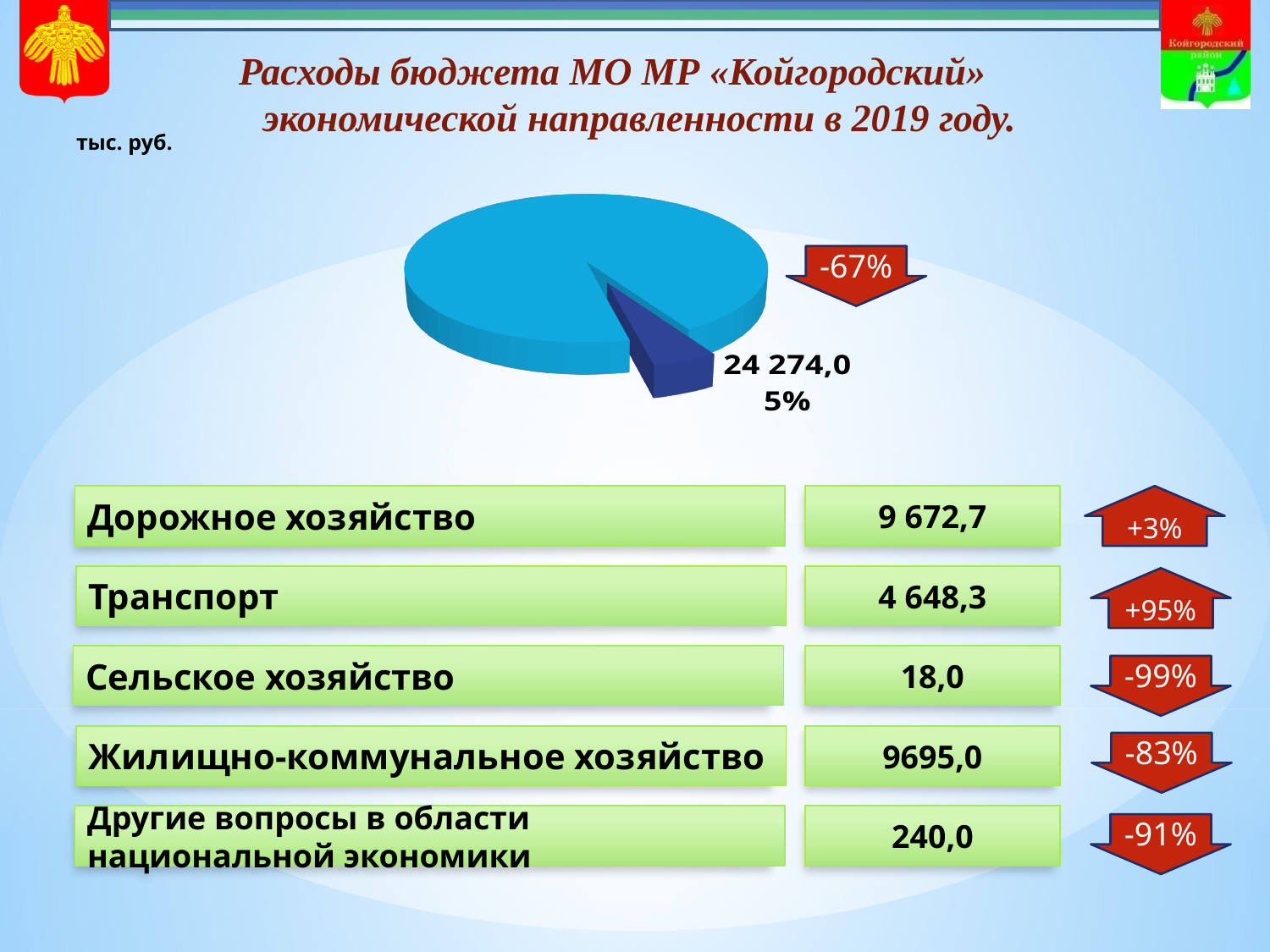
What share of the pie does the small dark blue slice represent? 5% How many slices does the pie chart have? 2 Is the share of the light blue slice in the pie chart greater or less than 50%? greater What kind of chart is shown on the slide? pie chart What value is printed on the small dark blue slice of the pie chart? 24 274,0 What percentage change is shown in the red arrow next to the pie chart? -67% In what units are the values on the slide given, according to the label in the top left? тыс. руб. Which slice of the pie chart is larger, the light blue one or the dark blue one? the light blue one Which slice of the pie chart is the smallest? the dark blue slice (24 274,0)